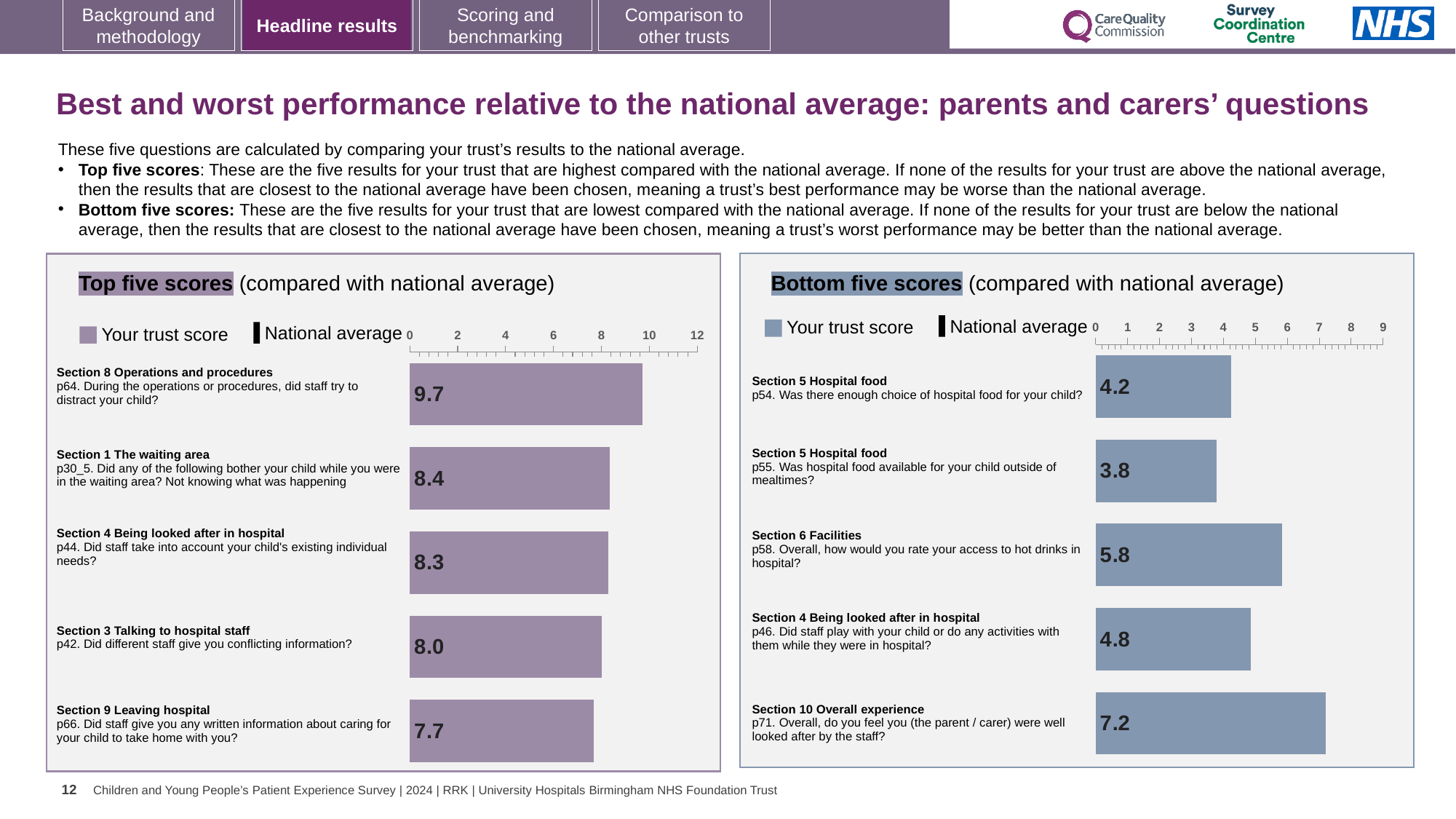
In the Top five scores chart, what is the difference between the trust scores for p64 and p66? 2.0 In the Bottom five scores chart, which question has the lowest trust score? p55. Was hospital food available for your child outside of mealtimes? What kind of chart is the Bottom five scores chart? Bar chart In the Top five scores chart, what is the trust score for p42 (Did different staff give you conflicting information?)? 8.0 In the Bottom five scores chart, which has the larger trust score: p54 (enough choice of hospital food) or p46 (staff play with your child)? p46 In the Top five scores chart, which question has the highest trust score? p64. During the operations or procedures, did staff try to distract your child? In the Top five scores chart, what is the trust score for p64 (During the operations or procedures, did staff try to distract your child?)? 9.7 How many questions are plotted in the Top five scores chart? 5 In the Bottom five scores chart, what is the trust score for p58 (Overall, how would you rate your access to hot drinks in hospital?)? 5.8 In the Bottom five scores chart, what is the difference between the trust scores for p71 and p54? 3.0 In the Bottom five scores chart, what is the trust score for p71 (Overall, do you feel you (the parent / carer) were well looked after by the staff?)? 7.2 How many series does the legend of the Top five scores chart list? 2